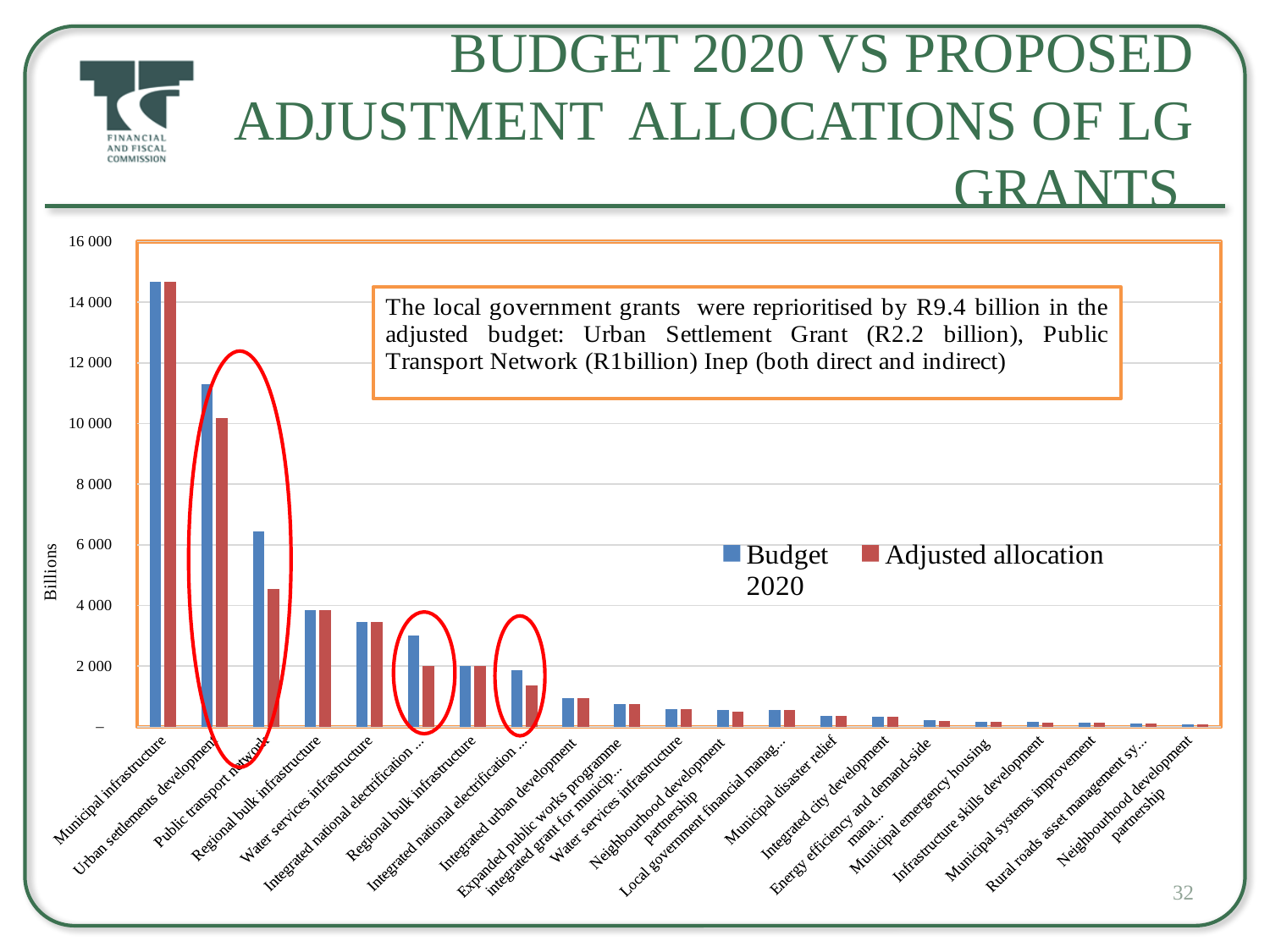
For Public transport network, which is larger: Budget 2020 or Adjusted allocation? Budget 2020 Is the Budget 2020 value for Municipal infrastructure greater or less than 14 000? greater Which category has the highest Budget 2020 value? Municipal infrastructure Is the Budget 2020 value for Public transport network greater or less than 6 000? greater Do the Budget 2020 values generally rise or fall from left to right along the x axis? fall What kind of chart is shown on the slide? Bar chart For Urban settlements development, which is larger: Budget 2020 or Adjusted allocation? Budget 2020 What colour represents the Adjusted allocation series? Red How many series does the legend list? 2 What is the label on the vertical axis? Billions Is the Budget 2020 value for Urban settlements development greater or less than 10 000? greater